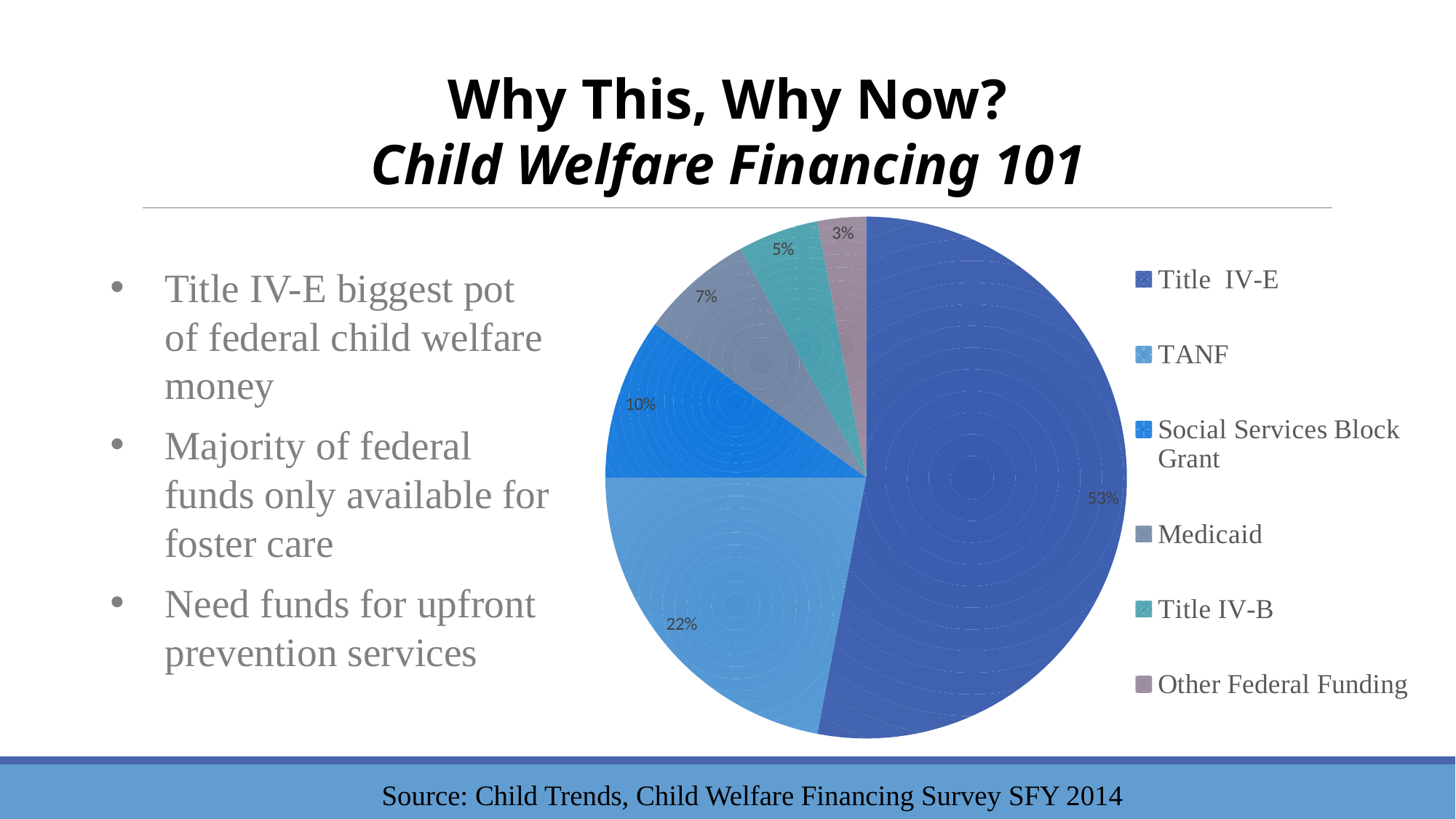
What share is labelled for Other Federal Funding? 3% What percentage does Medicaid account for? 7% What is the value shown for Title IV-B? 5% What percentage is shown for TANF? 22% Which category has the smallest slice of the pie? Other Federal Funding What kind of chart is shown on the slide? Pie chart What is the value for Social Services Block Grant? 10% What is the difference in percentage points between Title IV-E and TANF? 31 What share of the pie does Title IV-E represent? 53% Which category has the largest slice of the pie? Title IV-E Which is larger, Medicaid or Title IV-B? Medicaid How many categories does the legend list? 6